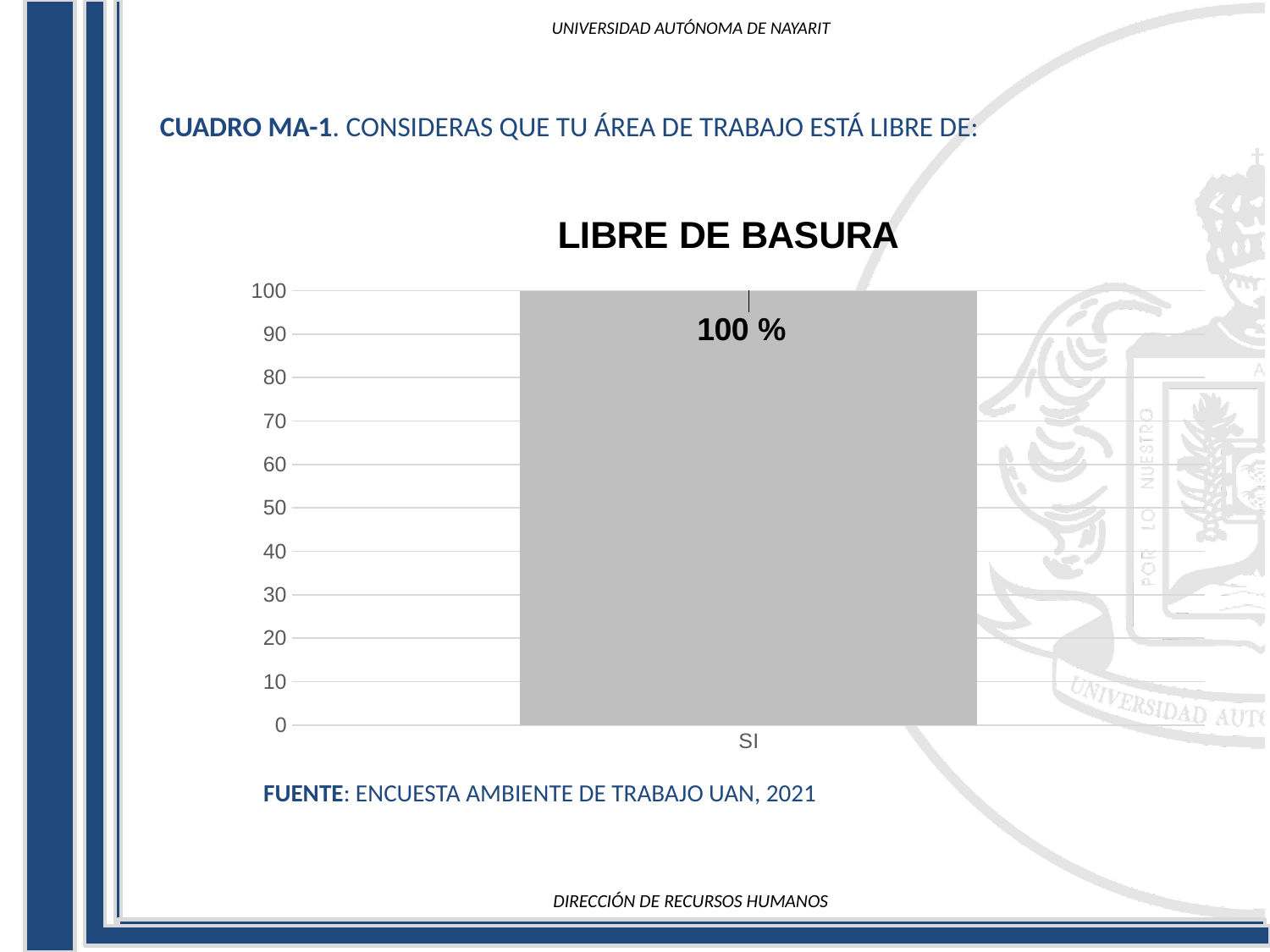
How many categories are plotted on the x axis? 1 What type of chart is shown on the slide? bar chart What is the title of the chart? LIBRE DE BASURA Which category has the highest value? SI What is the label of the single category on the x axis? SI Is the value for SI greater or less than 50? greater What is the value shown for the SI category? 100 % What is the maximum value shown on the y axis? 100